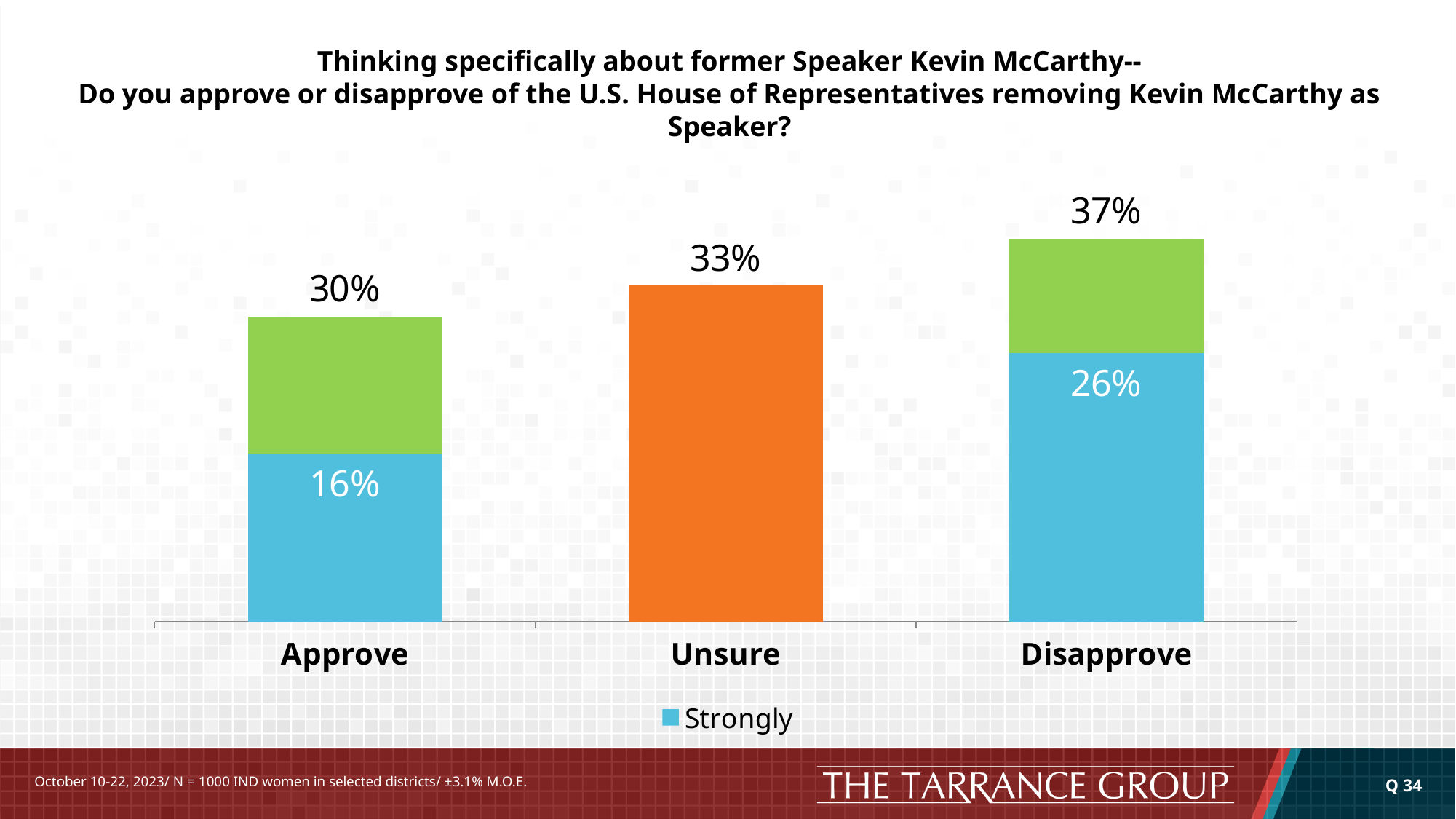
What is the total value shown for Disapprove? 37% What is the total value shown for Approve? 30% Which is larger, the value for Unsure or the total for Approve? Unsure What is the Strongly value within the Disapprove bar? 26% What is the Strongly value within the Approve bar? 16% Which category has the lowest total value? Approve Which category has the highest total value? Disapprove What is the difference between the Strongly values for Disapprove and Approve? 10% What is the value shown for Unsure? 33% How many categories are shown on the x axis? 3 What is the difference between the Disapprove total and the Approve total? 7% What kind of chart is shown on the slide? Bar chart